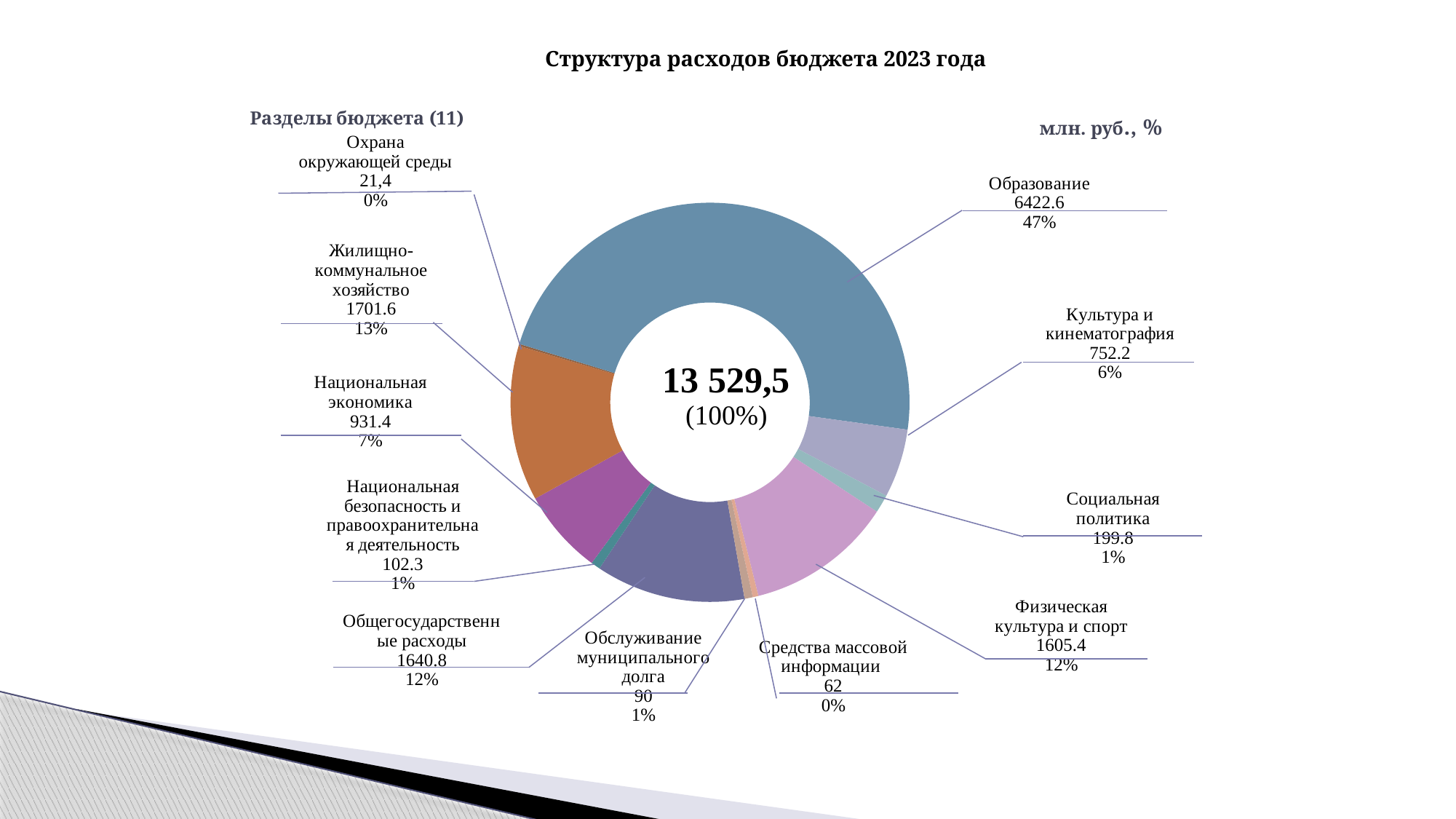
What is the difference between the values for Жилищно-коммунальное хозяйство and Общегосударственные расходы? 60.8 What is the value shown for Физическая культура и спорт? 1605.4 Which category has the smallest value in the chart? Охрана окружающей среды What percentage share does Образование have in the chart? 47% What is the value shown for Жилищно-коммунальное хозяйство? 1701.6 What is the title of the chart? Разделы бюджета (11) What type of chart is shown on the slide? Doughnut (pie) chart How many categories (sections) are shown in the chart? 11 Which is larger: Общегосударственные расходы or Национальная экономика? Общегосударственные расходы What is the total value shown in the centre of the chart? 13 529,5 What is the value shown for Образование? 6422.6 Which category has the largest value in the chart? Образование